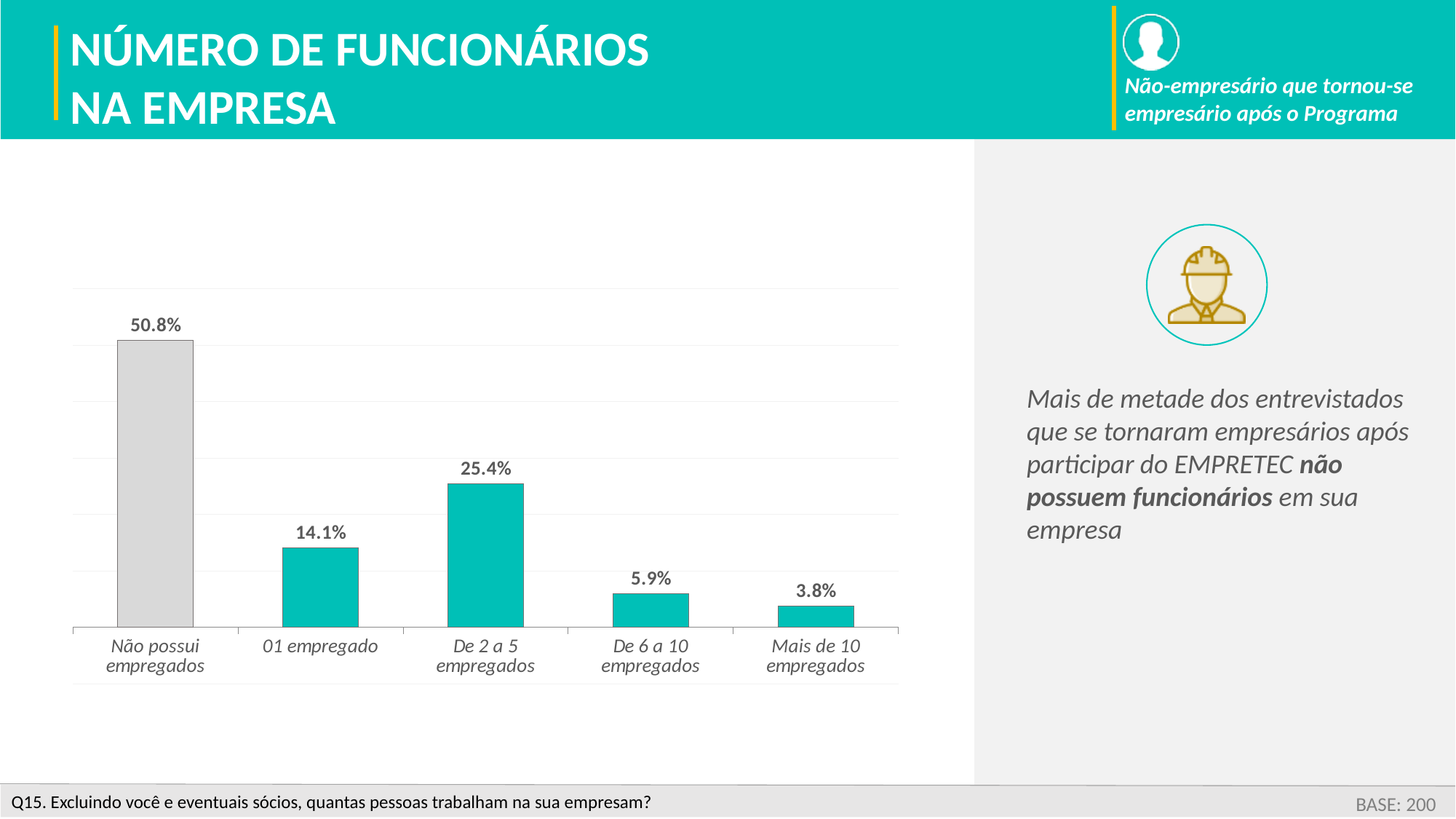
What is the value shown for '01 empregado'? 14.1% Which category has the highest value? Não possui empregados How many categories are shown on the x axis of the chart? 5 What is the value shown for 'Mais de 10 empregados'? 3.8% What is the value shown for 'De 2 a 5 empregados'? 25.4% Which is larger: the value for '01 empregado' or the value for 'De 6 a 10 empregados'? 01 empregado What is the difference between the values for 'Não possui empregados' and 'De 2 a 5 empregados'? 25.4% What is the difference between the values for 'De 6 a 10 empregados' and 'Mais de 10 empregados'? 2.1% Which category has the lowest value? Mais de 10 empregados Which bar is coloured grey instead of teal? Não possui empregados What kind of chart is shown on the slide? Bar chart What percentage of respondents have no employees (Não possui empregados)? 50.8%